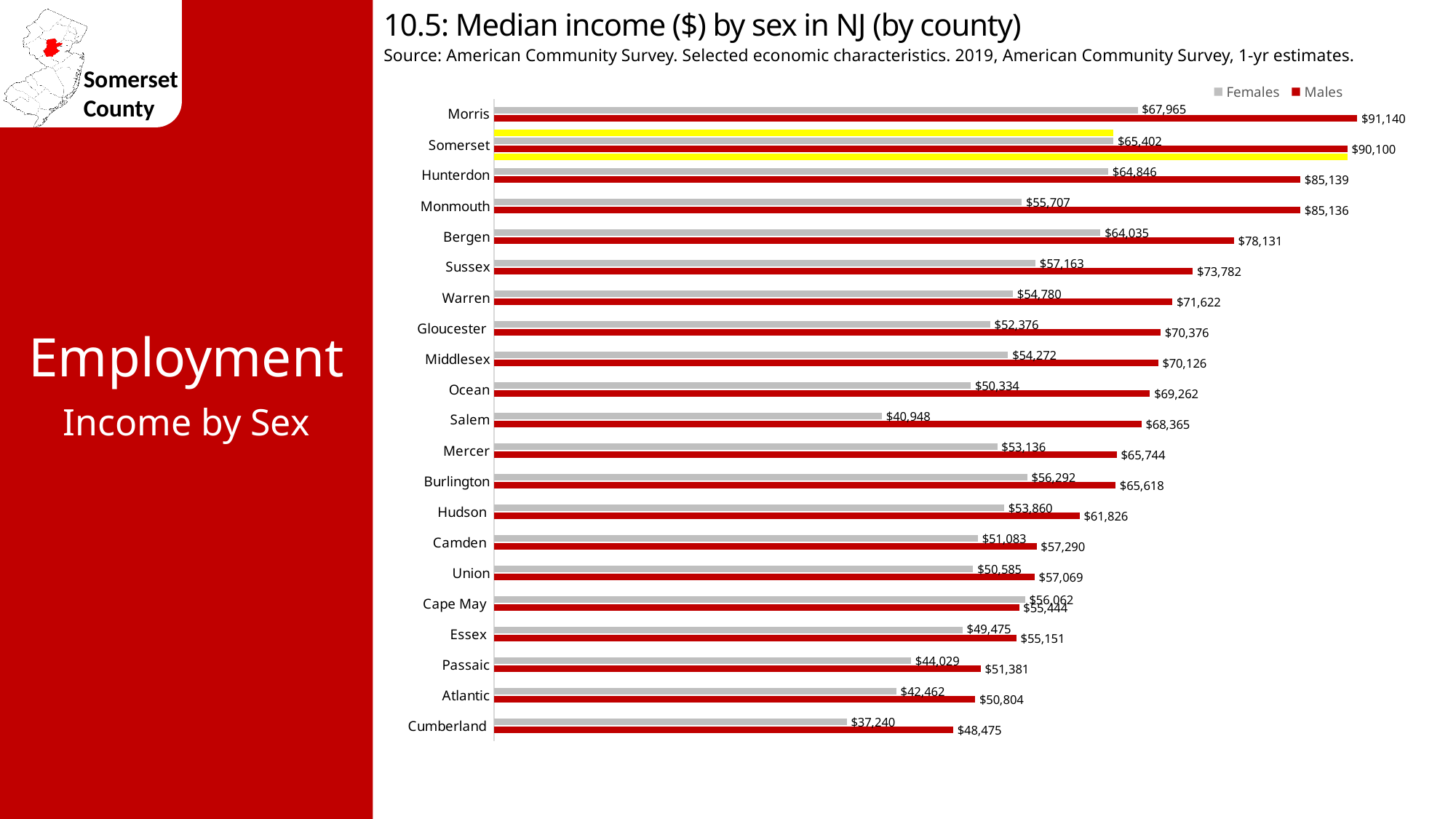
Which county has the highest median income for Males? Morris How many series does the legend list? 2 In Cape May County, which series has the higher median income, Females or Males? Females What is the difference between the Males median income in Morris County and in Somerset County? $1,040 What is the median income for Males in Somerset County? $90,100 What is the median income for Females in Salem County? $40,948 What is the median income for Males in Cumberland County? $48,475 Which county has the higher Females median income, Monmouth or Bergen? Bergen In Somerset County, how much higher is the Males median income than the Females median income? $24,698 Which county has the lowest median income for Females? Cumberland What kind of chart is shown on the slide? Bar chart How many counties are shown on the chart? 21